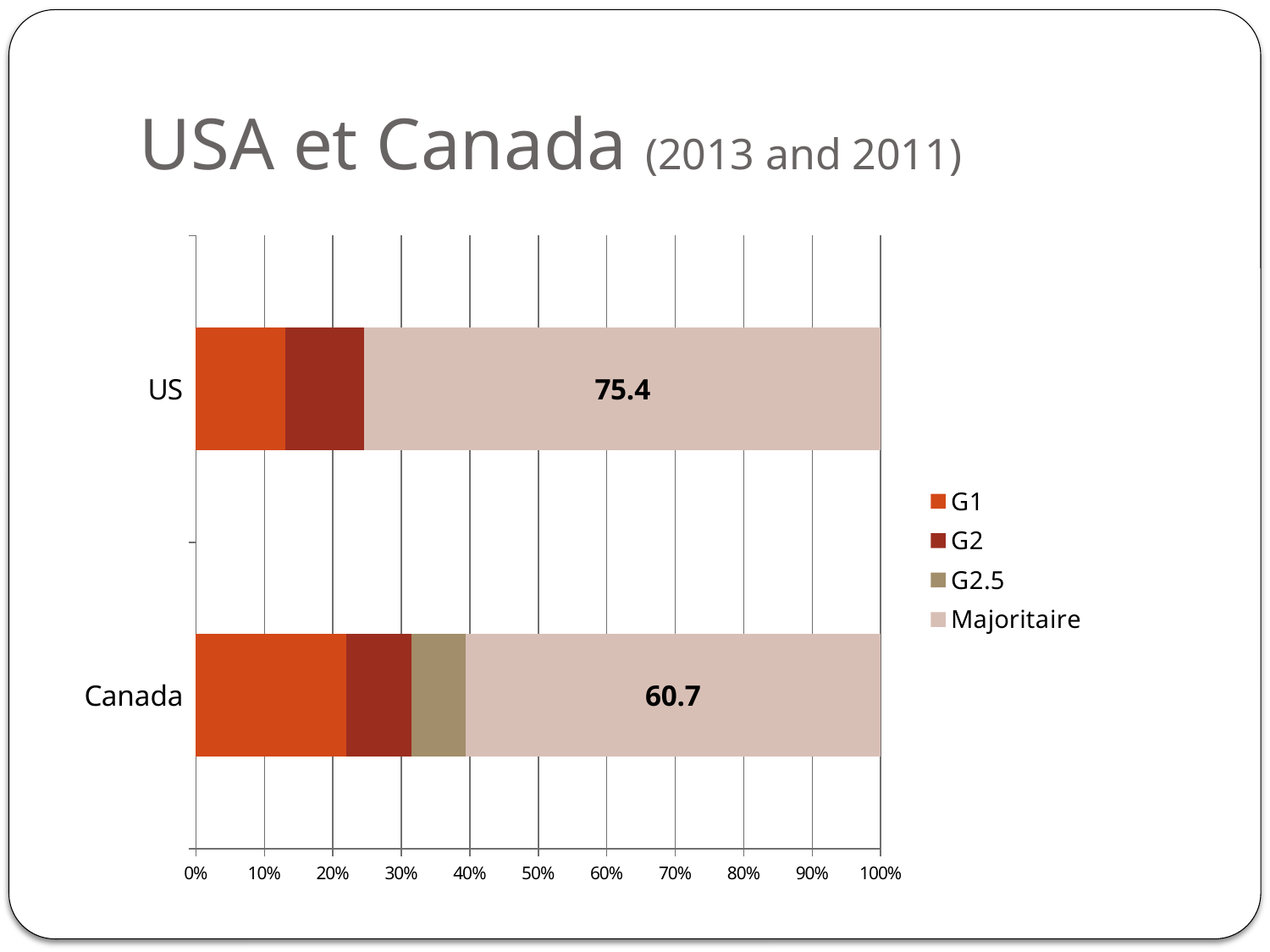
How many series does the legend list? 4 What kind of chart is shown on the slide? Stacked bar chart What is the Majoritaire value shown for Canada? 60.7 How many categories are shown on the chart? 2 What is the difference between the Majoritaire values for US and Canada? 14.7 Which category has the lowest Majoritaire value? Canada Is the G1 value for US greater or less than 20%? less Is the G1 value for Canada greater or less than 10%? greater Which category has the highest Majoritaire value? US Which has the larger Majoritaire value, US or Canada? US Which category's bar includes a G2.5 segment? Canada What is the Majoritaire value shown for US? 75.4